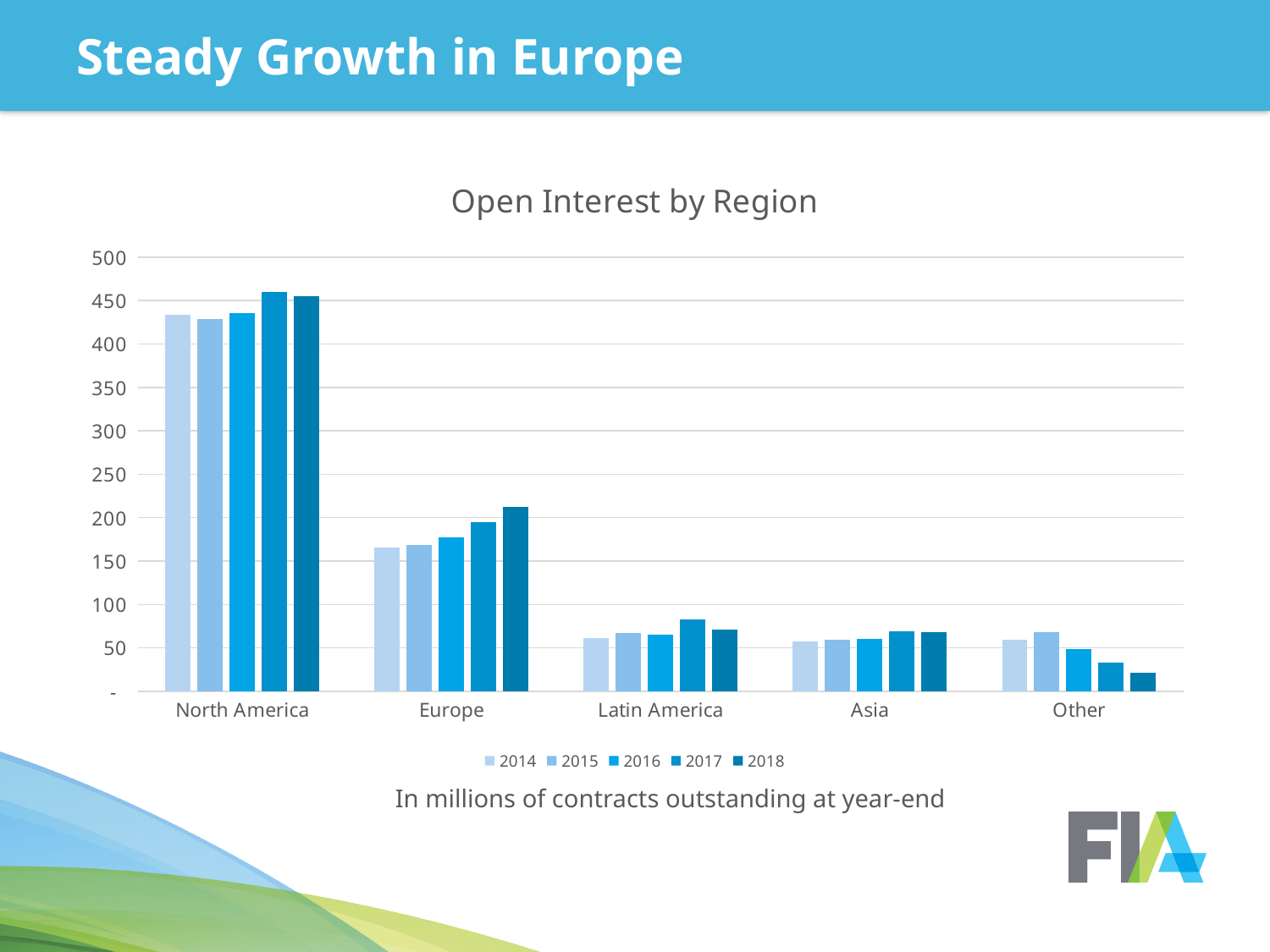
Is the value for Asia in 2018 greater or less than 100? less Which region has the highest open interest in 2018? North America Which is larger in 2018, the value for Europe or the value for Latin America? Europe How many regions are shown on the x axis? 5 Is the value for North America in 2017 greater or less than 400? greater What kind of chart is shown on the slide? bar chart Do the values for Other rise or fall from 2015 to 2018? fall How many series does the legend list? 5 Is the value for Europe in 2018 greater or less than 200? greater Do the values for Europe rise or fall from 2014 to 2018? rise Which region has the lowest open interest in 2018? Other What is the title of the chart? Open Interest by Region